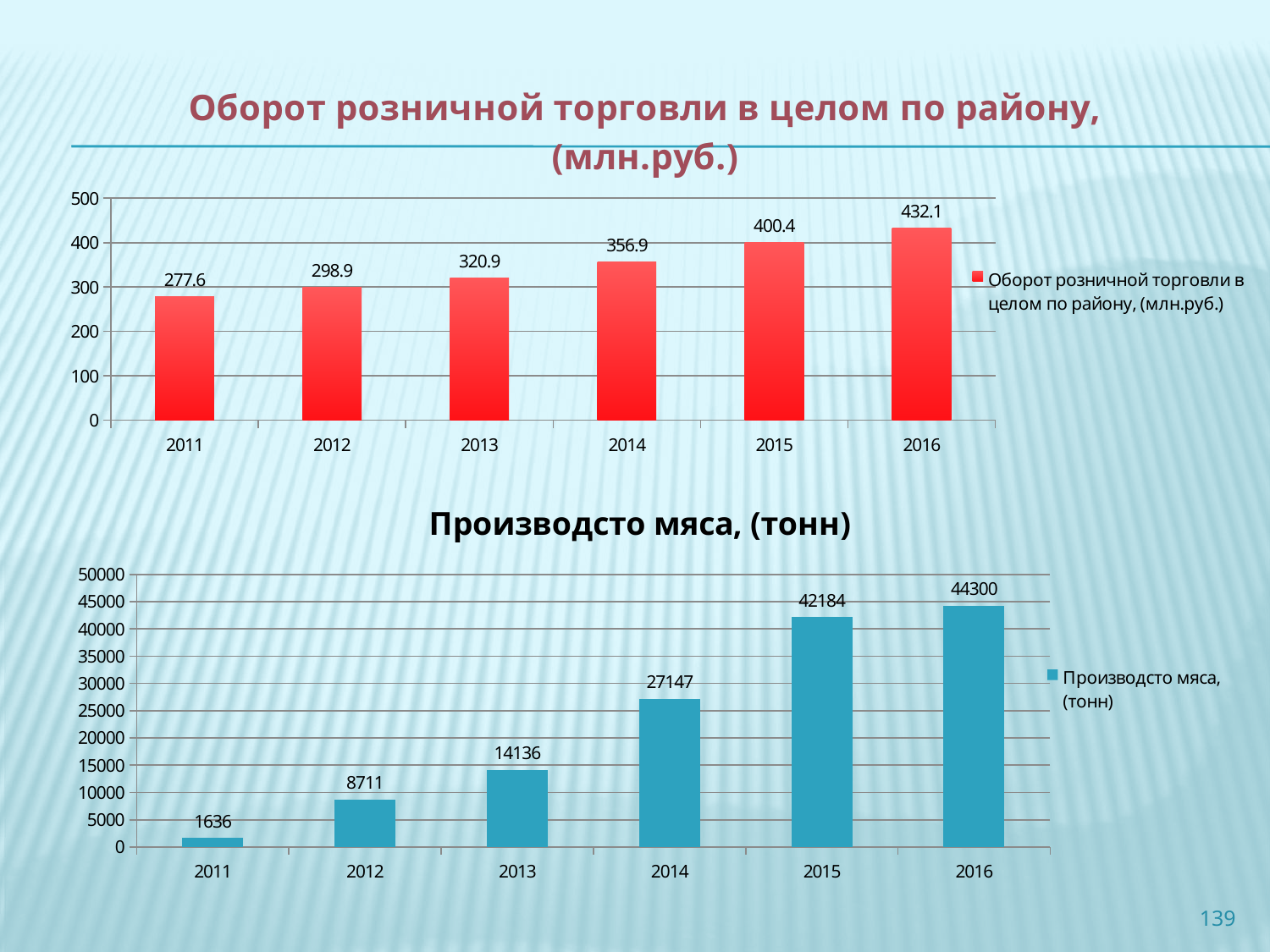
In the top chart (Оборот розничной торговли в целом по району), which year has the lowest value? 2011 In the top chart (Оборот розничной торговли в целом по району), what is the difference between the values for 2016 and 2011? 154.5 In the bottom chart (Производсто мяса, (тонн)), what is the difference between the values for 2016 and 2015? 2116 What kind of chart is the bottom chart (Производсто мяса, (тонн))? bar chart In the top chart (Оборот розничной торговли в целом по району), what is the value for 2013? 320.9 In the bottom chart (Производсто мяса, (тонн)), what is the value for 2014? 27147 In the bottom chart (Производсто мяса, (тонн)), which is larger, the value for 2015 or the value for 2014? 2015 How many series does the legend of the bottom chart (Производсто мяса, (тонн)) list? 1 In the top chart (Оборот розничной торговли в целом по району), how many years are shown on the x axis? 6 In the top chart (Оборот розничной торговли в целом по району), do the values rise or fall from 2011 to 2016? rise In the bottom chart (Производсто мяса, (тонн)), what is the value for 2011? 1636 In the top chart (Оборот розничной торговли в целом по району), which year has the highest value? 2016